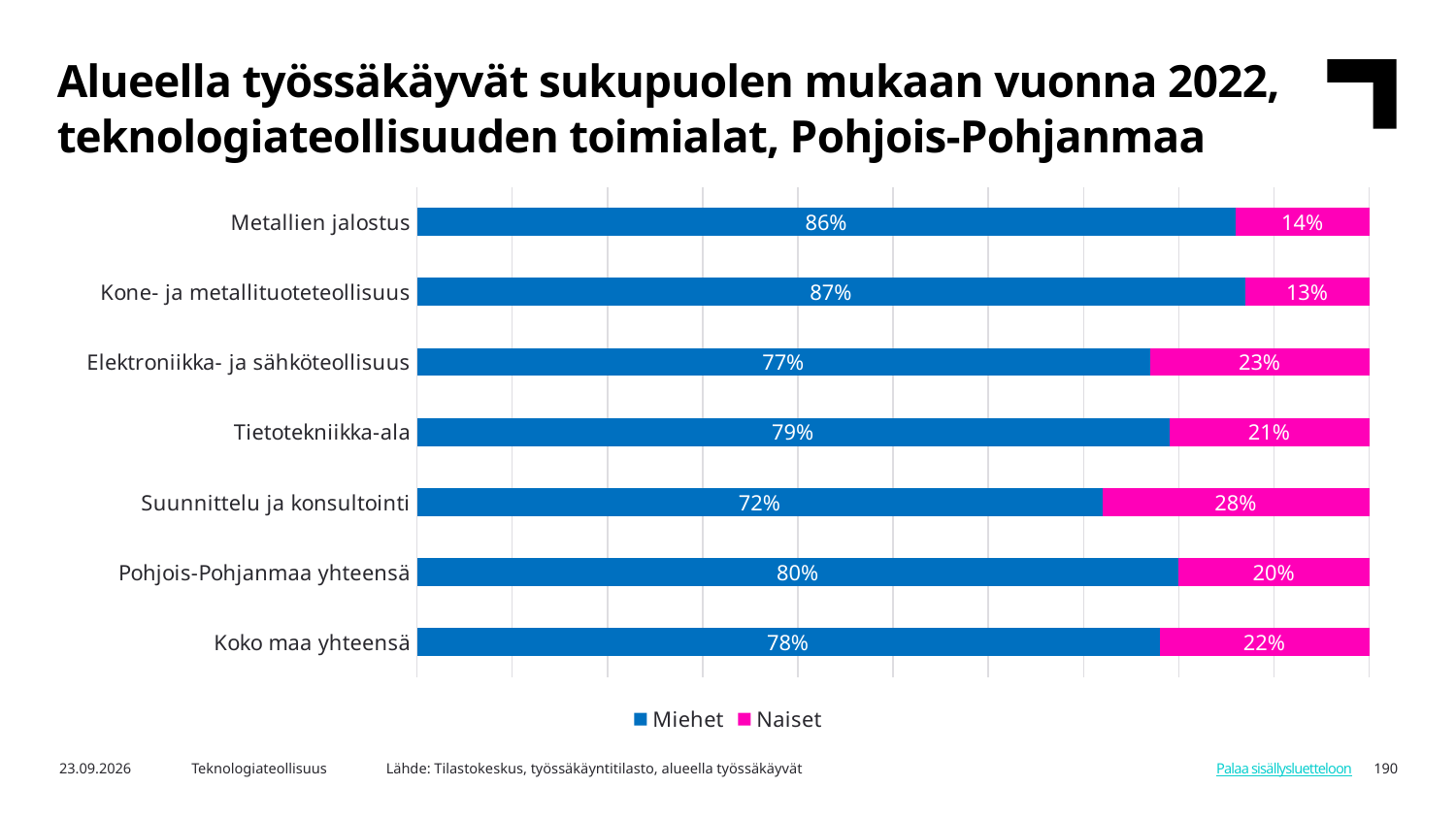
Which category has the highest Miehet share? Kone- ja metallituoteteollisuus How many categories are shown on the chart? 7 Which category has the lowest Naiset share? Kone- ja metallituoteteollisuus What is the Naiset share for Suunnittelu ja konsultointi? 28% What is the total of the stacked bar for Pohjois-Pohjanmaa yhteensä? 100% What is the Naiset share for Koko maa yhteensä? 22% Which colour represents Naiset in the chart? Magenta (pink) What kind of chart is shown on the slide? Stacked bar chart What is the Miehet share for Metallien jalostus? 86% What is the difference between the Miehet share for Metallien jalostus and for Suunnittelu ja konsultointi? 14 percentage points How many series does the legend list? 2 Which is larger: the Naiset share for Elektroniikka- ja sähköteollisuus or for Tietotekniikka-ala? Elektroniikka- ja sähköteollisuus